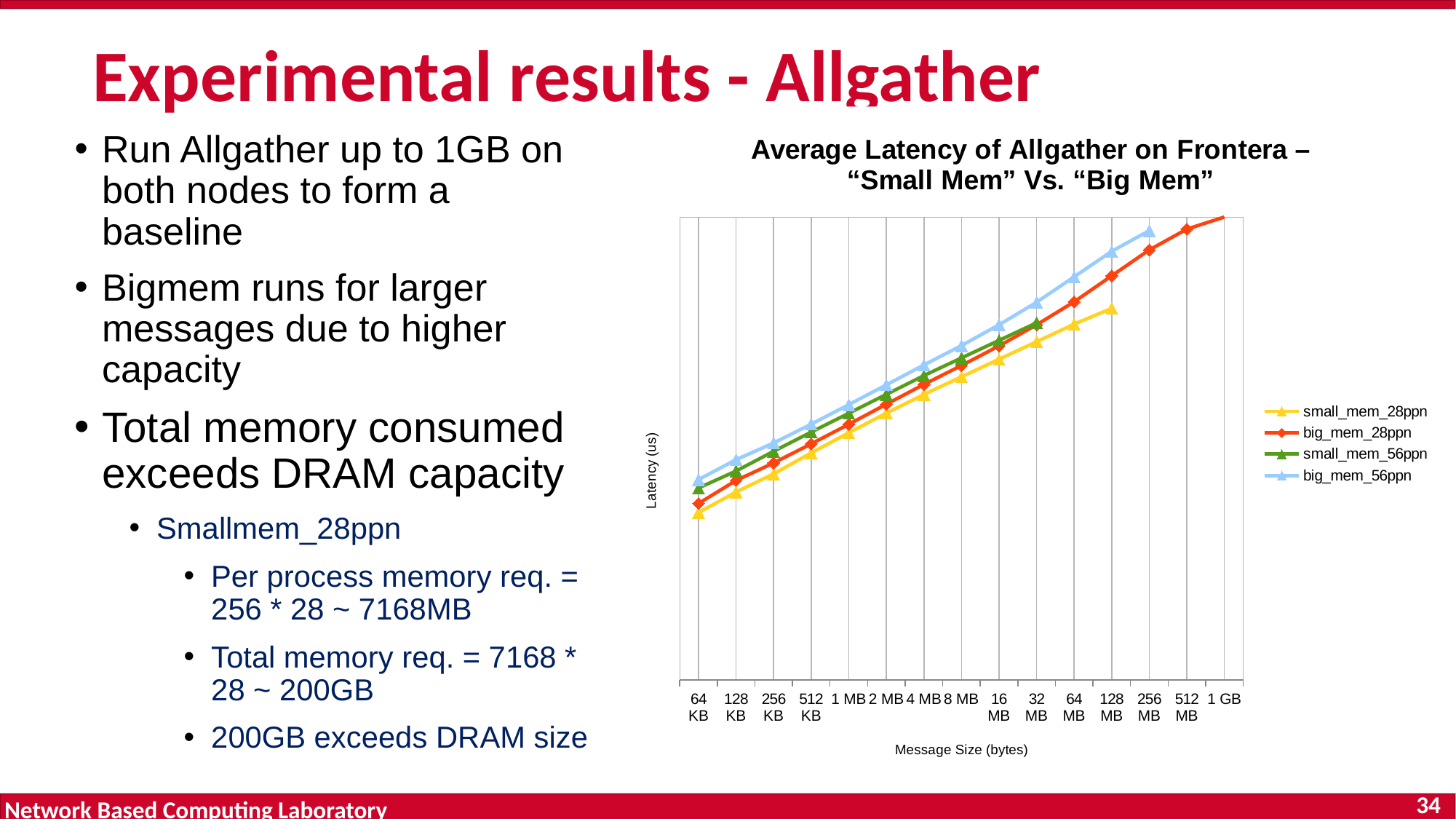
How many message-size categories are shown on the x axis? 15 How many series does the legend list? 4 Does the latency rise or fall as message size increases along the x axis? rise What is the title of the chart? Average Latency of Allgather on Frontera – "Small Mem" Vs. "Big Mem" Which series has the highest latency at 32 MB? big_mem_56ppn Which series has the lowest latency at 32 MB? small_mem_28ppn Which series stops at the smallest message size, 32 MB? small_mem_56ppn At 128 MB, which has the higher latency, big_mem_28ppn or small_mem_28ppn? big_mem_28ppn Which series extends to the largest message size, 1 GB? big_mem_28ppn What is the label of the x axis? Message Size (bytes) What kind of chart is shown on the slide? line chart At 64 KB, which has the higher latency, big_mem_56ppn or small_mem_28ppn? big_mem_56ppn